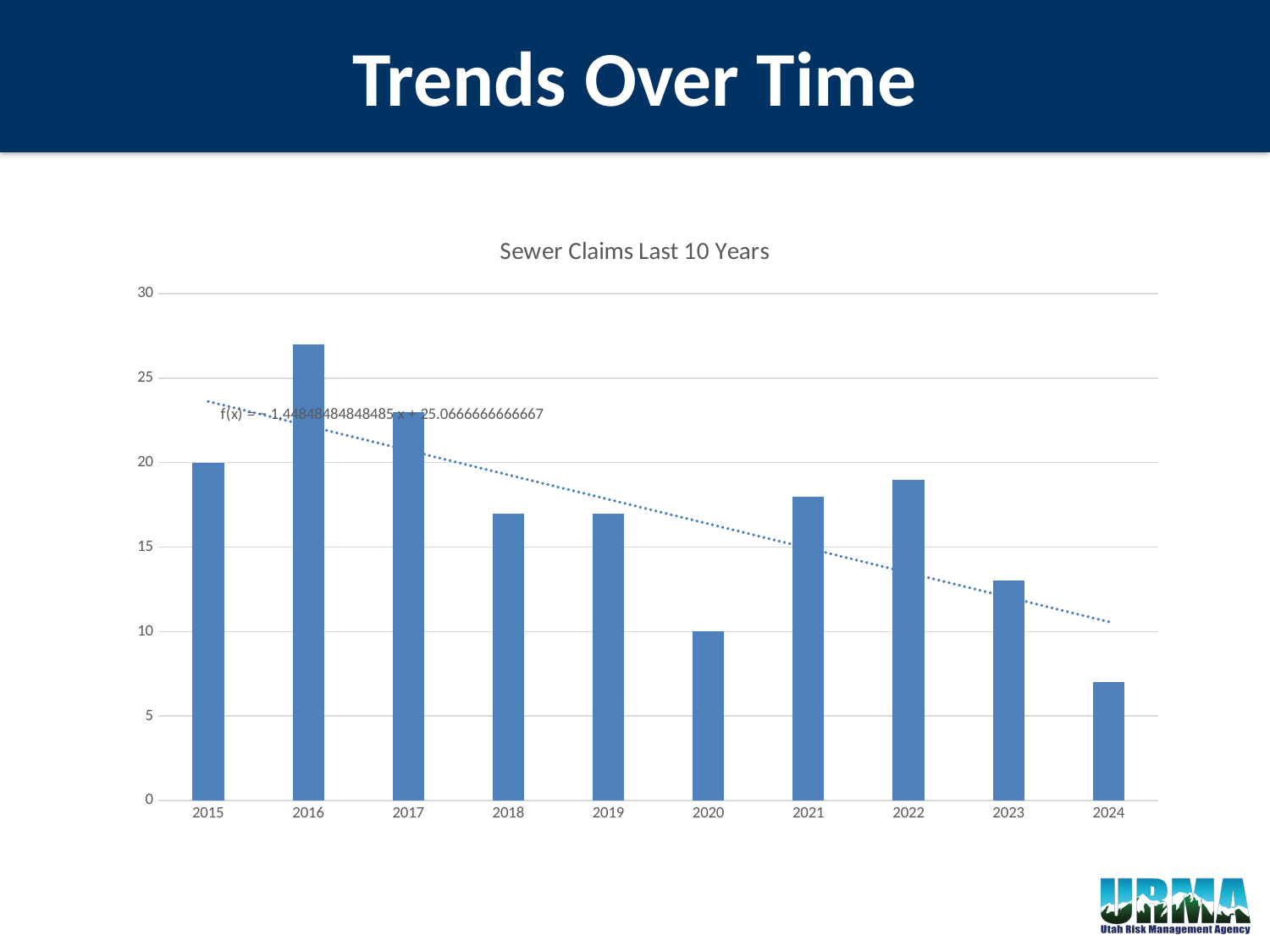
Which year has the lowest number of sewer claims? 2024 What is the value for 2015? 20 How many years are plotted on the x axis? 10 Which year has the highest number of sewer claims? 2016 What is the title of the chart? Sewer Claims Last 10 Years What is the difference between the values for 2015 and 2020? 10 Is the value for 2016 greater or less than 25? greater Is the value for 2024 greater or less than 10? less What type of chart is shown on the slide? bar chart Which is larger, the value for 2022 or the value for 2023? 2022 What is the value for 2020? 10 Do the values generally rise or fall from 2015 to 2024? fall